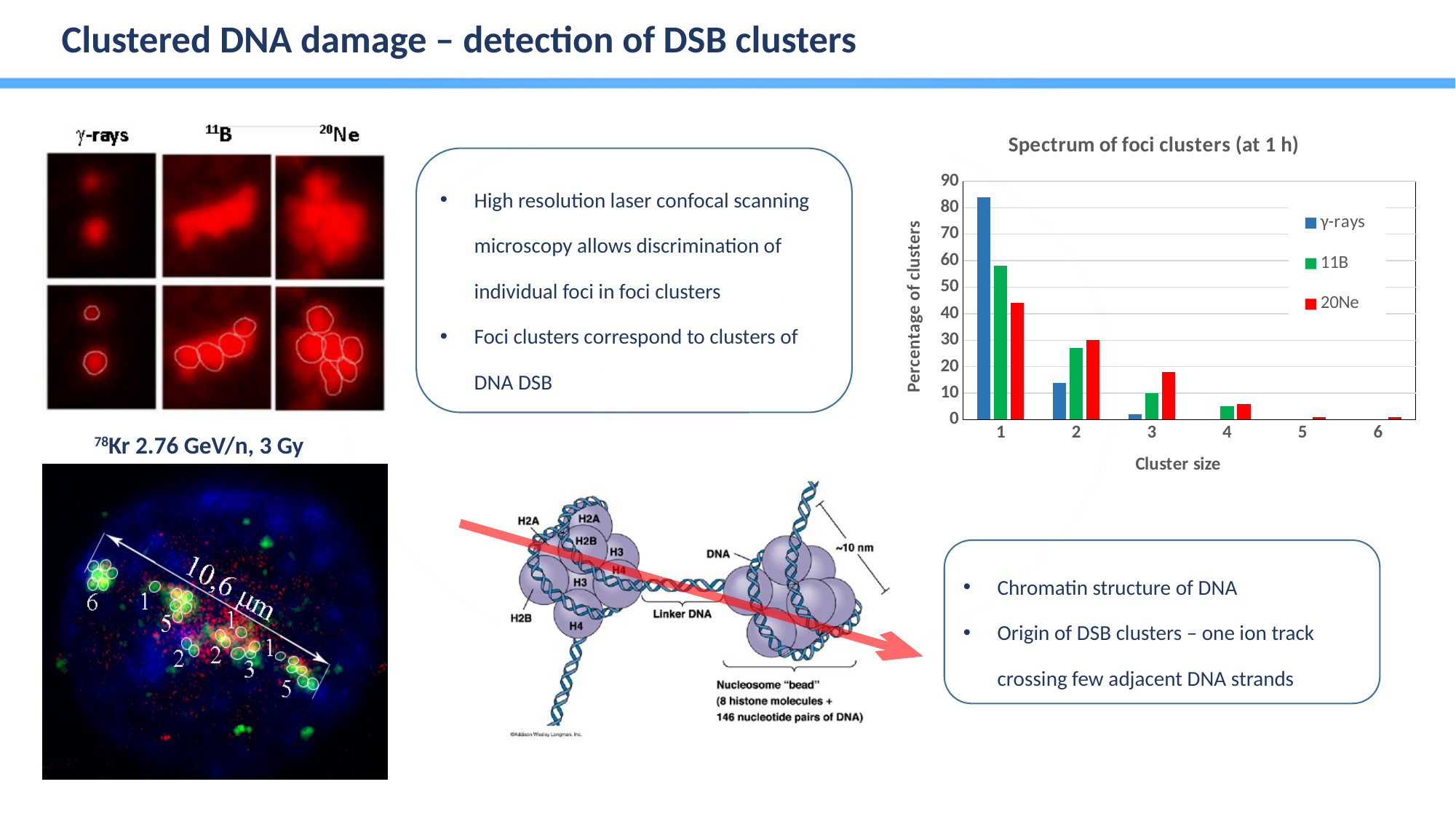
How many series does the legend of the 'Spectrum of foci clusters (at 1 h)' chart list? 3 In the 'Spectrum of foci clusters (at 1 h)' chart, do the 20Ne values rise or fall as cluster size increases from 1 to 4? fall In the 'Spectrum of foci clusters (at 1 h)' chart, which cluster size has the highest percentage of clusters for γ-rays? 1 How many cluster size categories are shown on the x axis of the 'Spectrum of foci clusters (at 1 h)' chart? 6 What is the label of the y axis in the 'Spectrum of foci clusters (at 1 h)' chart? Percentage of clusters In the 'Spectrum of foci clusters (at 1 h)' chart, is the γ-rays value for cluster size 1 greater or less than 80? greater In the 'Spectrum of foci clusters (at 1 h)' chart, which series has the larger value at cluster size 3, 11B or 20Ne? 20Ne What kind of chart is 'Spectrum of foci clusters (at 1 h)'? bar chart In the 'Spectrum of foci clusters (at 1 h)' chart, which series has the larger value at cluster size 1, γ-rays or 11B? γ-rays In the 'Spectrum of foci clusters (at 1 h)' chart, is the 20Ne value for cluster size 1 greater or less than 50? less In the 'Spectrum of foci clusters (at 1 h)' chart, is the 11B value for cluster size 2 greater or less than 20? greater What colour represents the 20Ne series in the 'Spectrum of foci clusters (at 1 h)' chart? red